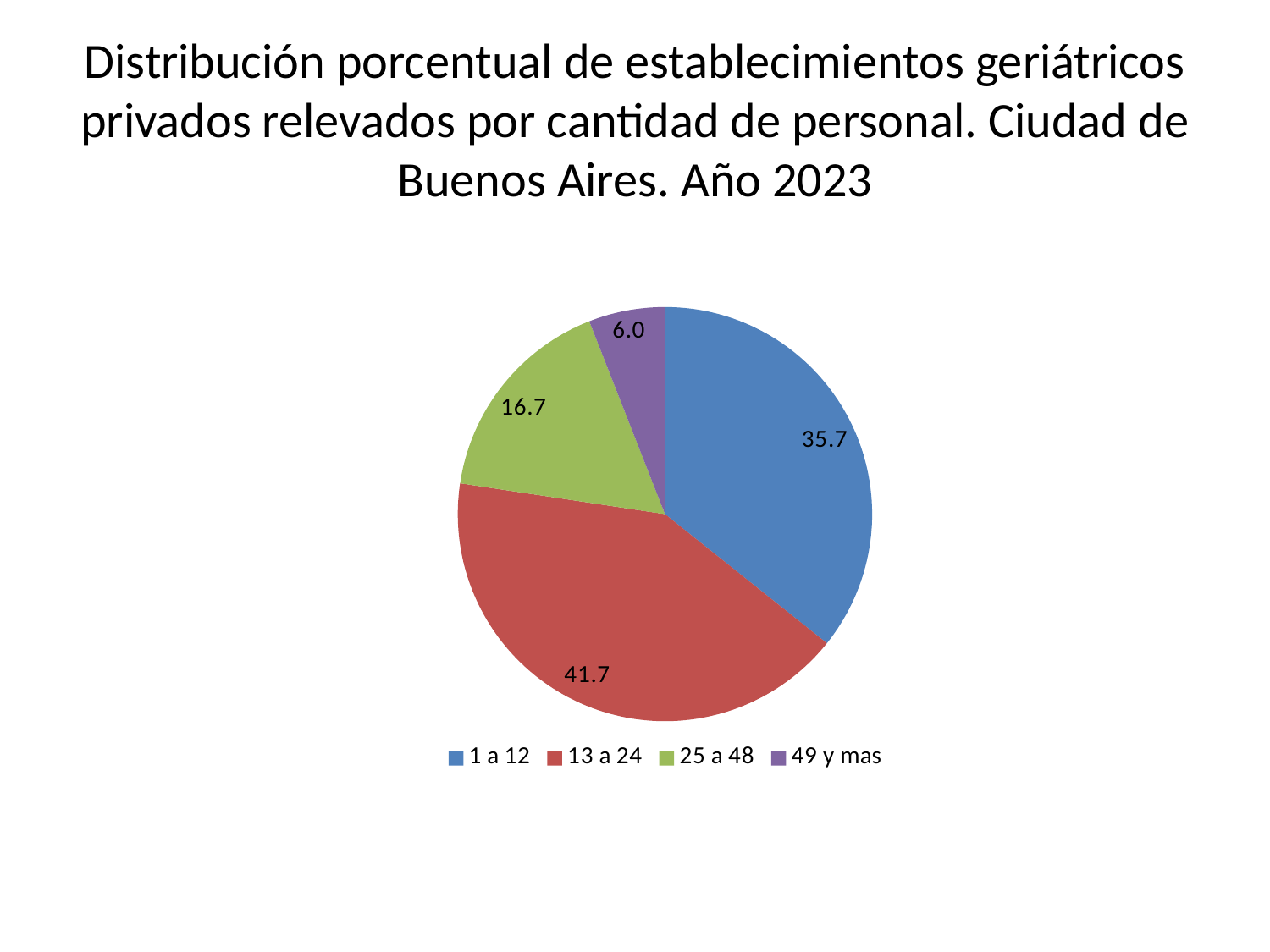
What is the value for the "49 y mas" category? 6.0 What is the value for the "25 a 48" category? 16.7 Which is larger, the value for "1 a 12" or the value for "25 a 48"? 1 a 12 What colour is the slice for "13 a 24"? Red What is the value for the "1 a 12" category? 35.7 What is the difference between the values for "13 a 24" and "1 a 12"? 6.0 How many categories does the pie chart have? 4 Which category has the smallest slice of the pie? 49 y mas What is the value for the "13 a 24" category? 41.7 What kind of chart is shown on the slide? Pie chart What is the difference between the values for "25 a 48" and "49 y mas"? 10.7 Which category has the largest slice of the pie? 13 a 24